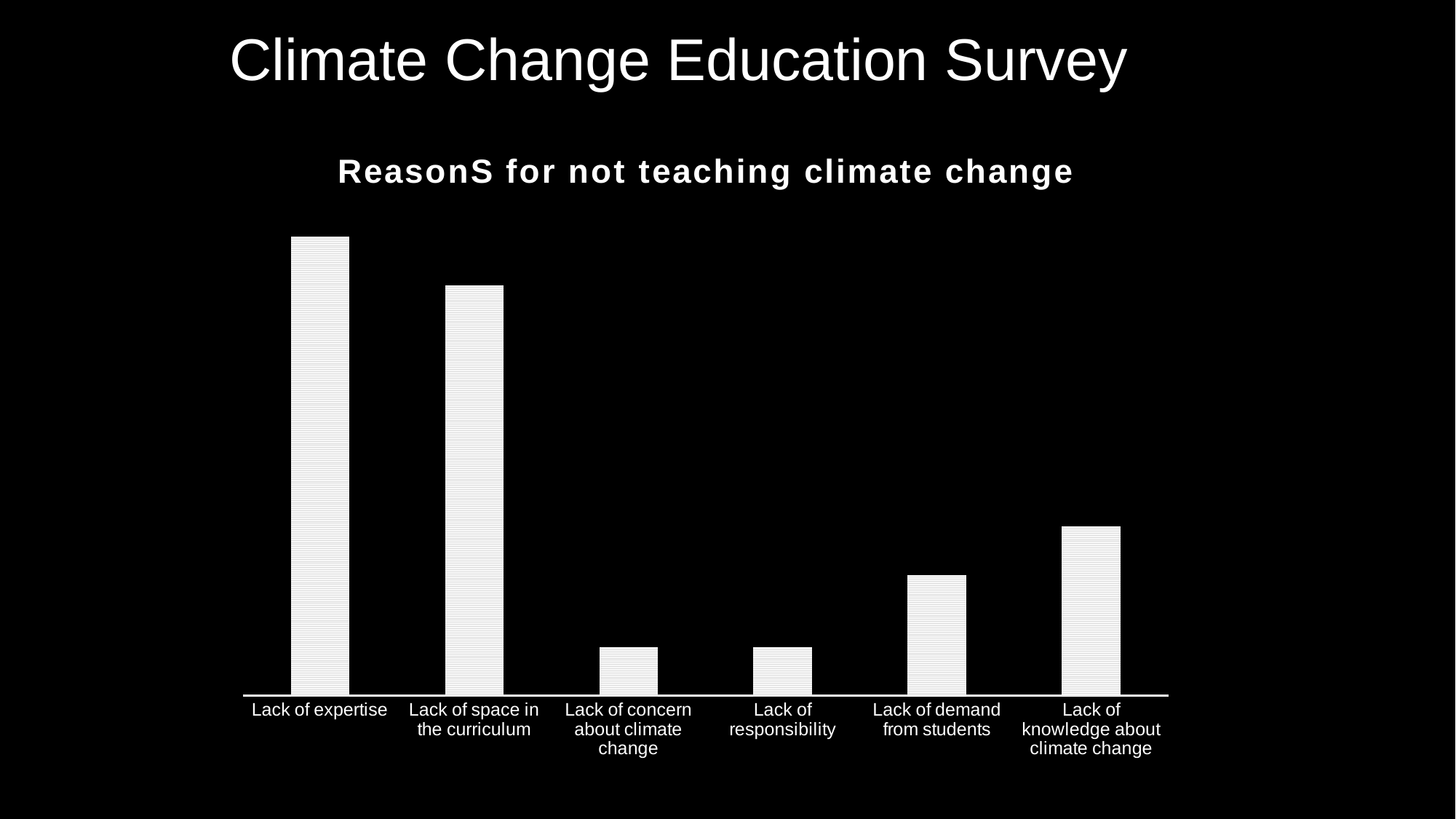
How many categories (reasons) are shown on the chart? 6 Which reason has the second-highest bar? Lack of space in the curriculum Which reason has the highest bar? Lack of expertise Which is larger, the bar for Lack of demand from students or the bar for Lack of knowledge about climate change? Lack of knowledge about climate change What is the label of the first category on the left of the x axis? Lack of expertise Which is larger, the bar for Lack of expertise or the bar for Lack of space in the curriculum? Lack of expertise What is the title of the chart? ReasonS for not teaching climate change Which is larger, the bar for Lack of responsibility or the bar for Lack of knowledge about climate change? Lack of knowledge about climate change What kind of chart is shown on the slide? bar chart